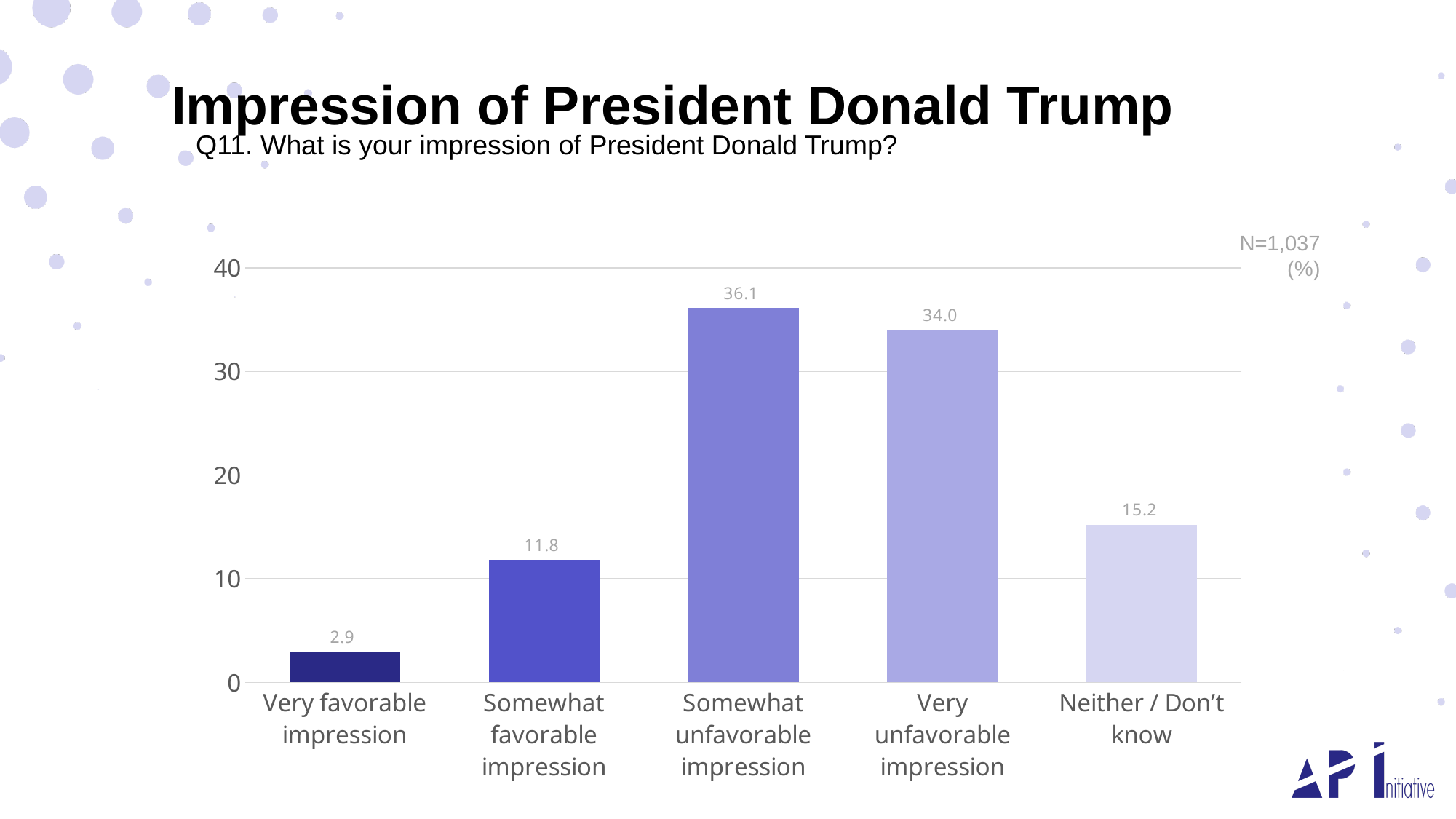
Which category has the highest value? Somewhat unfavorable impression What is the value for "Very favorable impression"? 2.9 What is the value for "Neither / Don't know"? 15.2 What is the sample size (N) shown on the chart? N=1,037 Which is larger, "Somewhat favorable impression" or "Neither / Don't know"? Neither / Don't know What is the value for "Somewhat unfavorable impression"? 36.1 Is the value for "Very unfavorable impression" greater or less than 30? greater What is the difference between "Somewhat unfavorable impression" and "Very unfavorable impression"? 2.1 How many categories are shown on the x axis? 5 Which category has the lowest value? Very favorable impression What kind of chart is shown on the slide? Bar chart What is the difference between "Neither / Don't know" and "Somewhat favorable impression"? 3.4